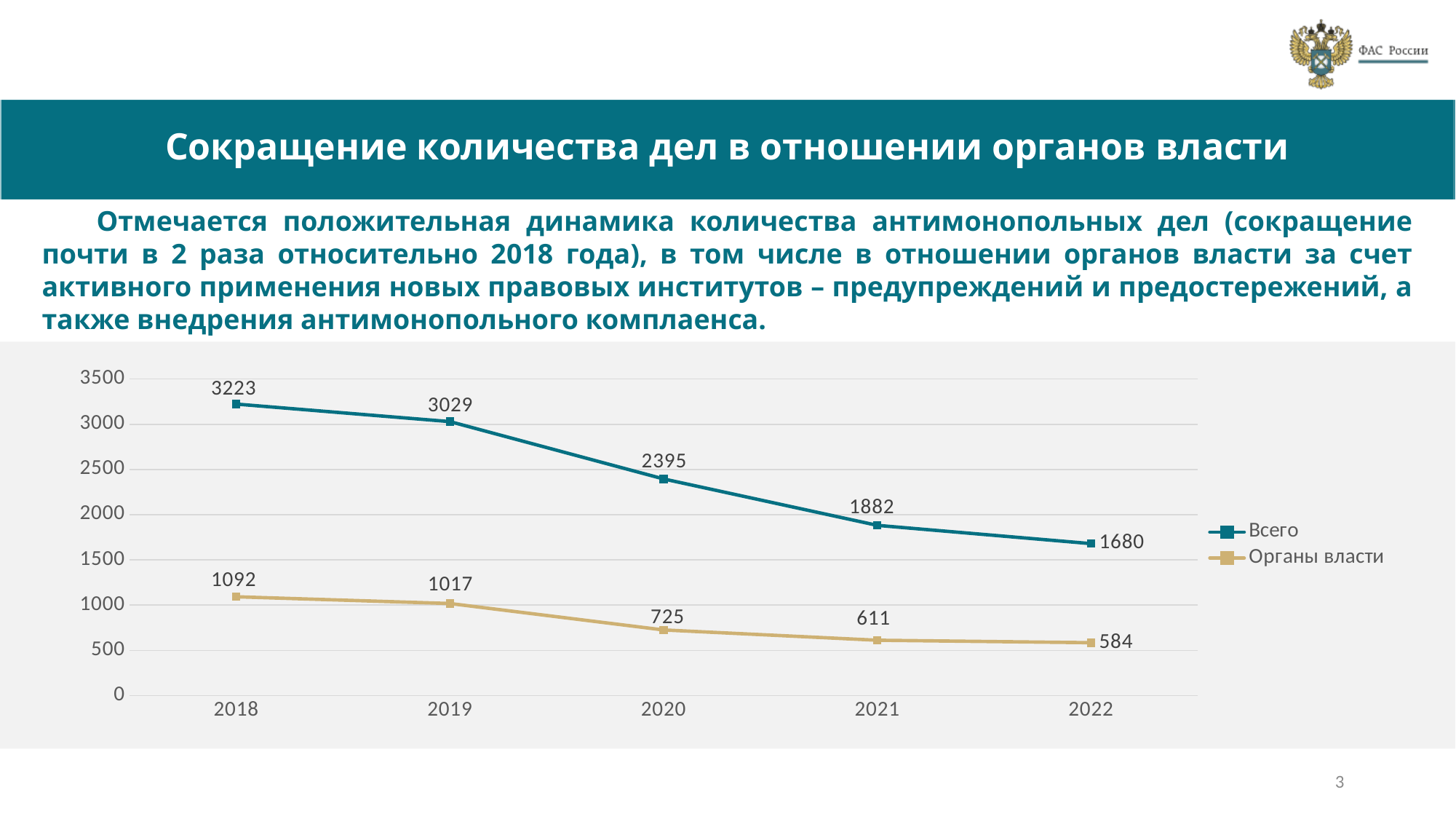
In which year is the "Всего" series highest? 2018 What is the difference between the "Всего" values for 2018 and 2022? 1543 What is the value of the "Органы власти" series in 2022? 584 Is the "Всего" value for 2021 greater or less than 2000? less Which is larger: the "Органы власти" value in 2019 or in 2020? 2019 How many years are shown on the x axis? 5 How many series does the legend list? 2 What is the difference between the "Всего" and "Органы власти" values in 2021? 1271 In which year is the "Органы власти" series lowest? 2022 What is the value of the "Всего" series in 2020? 2395 What kind of chart is shown on the slide? line chart Do the values of the "Органы власти" series rise or fall from 2018 to 2022? fall